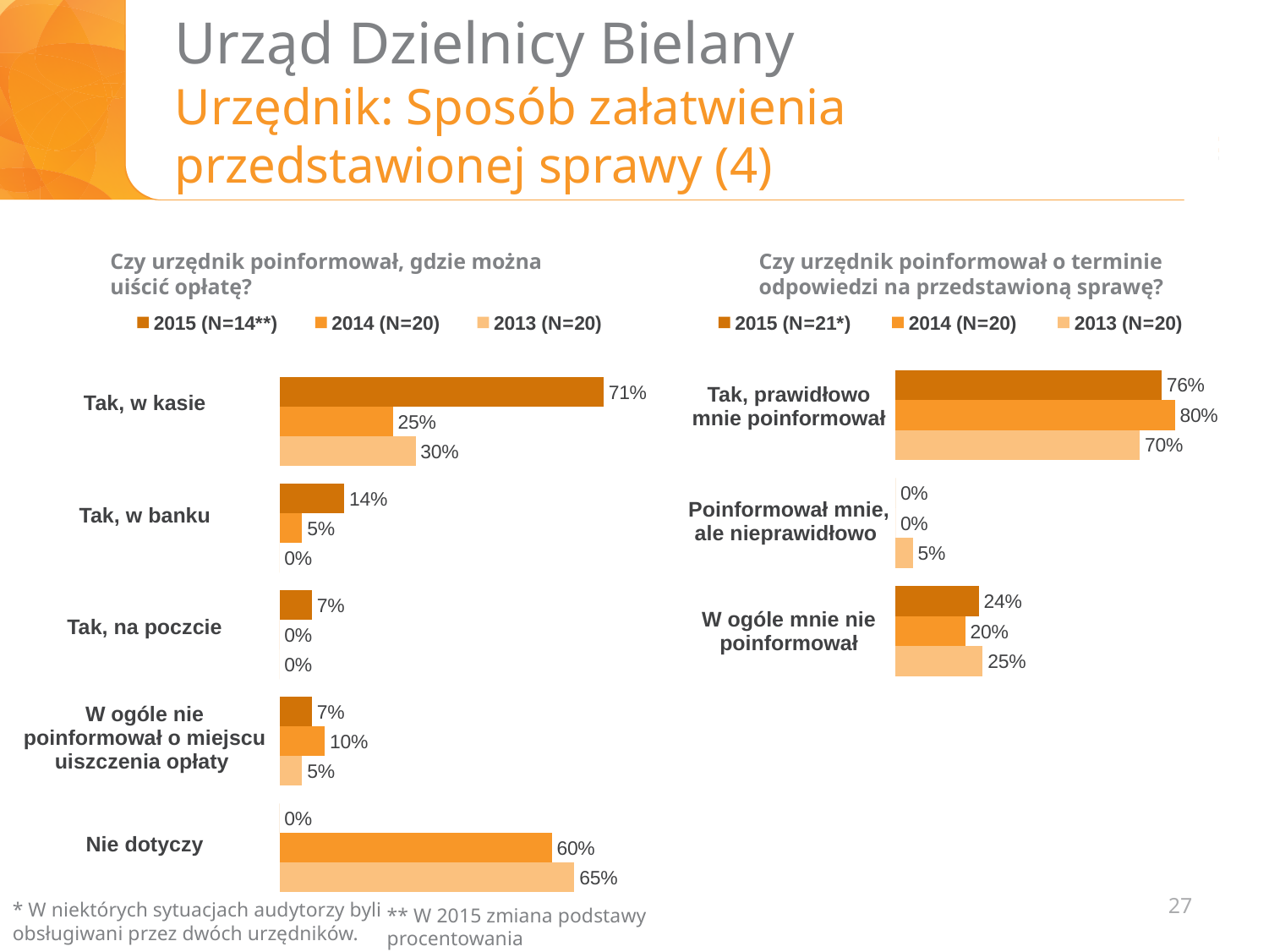
In the right chart ("Czy urzędnik poinformował o terminie odpowiedzi na przedstawioną sprawę?"), what is the value for "Tak, prawidłowo mnie poinformował" in 2014? 80% What kind of chart is the right chart ("Czy urzędnik poinformował o terminie odpowiedzi na przedstawioną sprawę?")? bar chart In the left chart ("Czy urzędnik poinformował, gdzie można uiścić opłatę?"), what is the value for "Nie dotyczy" in 2013? 65% In the right chart ("Czy urzędnik poinformował o terminie odpowiedzi na przedstawioną sprawę?"), what is the sample size shown in the legend for 2015? N=21* In the right chart ("Czy urzędnik poinformował o terminie odpowiedzi na przedstawioną sprawę?"), is the 2013 value for "W ogóle mnie nie poinformował" larger or smaller than the 2014 value? larger In the left chart ("Czy urzędnik poinformował, gdzie można uiścić opłatę?"), how many series does the legend list? 3 In the right chart ("Czy urzędnik poinformował o terminie odpowiedzi na przedstawioną sprawę?"), which year has the highest value for "Tak, prawidłowo mnie poinformował"? 2014 (N=20) In the left chart ("Czy urzędnik poinformował, gdzie można uiścić opłatę?"), which category has the highest value for 2014? Nie dotyczy In the right chart ("Czy urzędnik poinformował o terminie odpowiedzi na przedstawioną sprawę?"), what is the value for "W ogóle mnie nie poinformował" in 2015? 24% In the left chart ("Czy urzędnik poinformował, gdzie można uiścić opłatę?"), what is the difference between the 2015 and 2014 values for "Tak, w kasie"? 46 percentage points In the left chart ("Czy urzędnik poinformował, gdzie można uiścić opłatę?"), how many categories are shown? 5 In the left chart ("Czy urzędnik poinformował, gdzie można uiścić opłatę?"), what is the value for "Tak, w kasie" in 2015? 71%